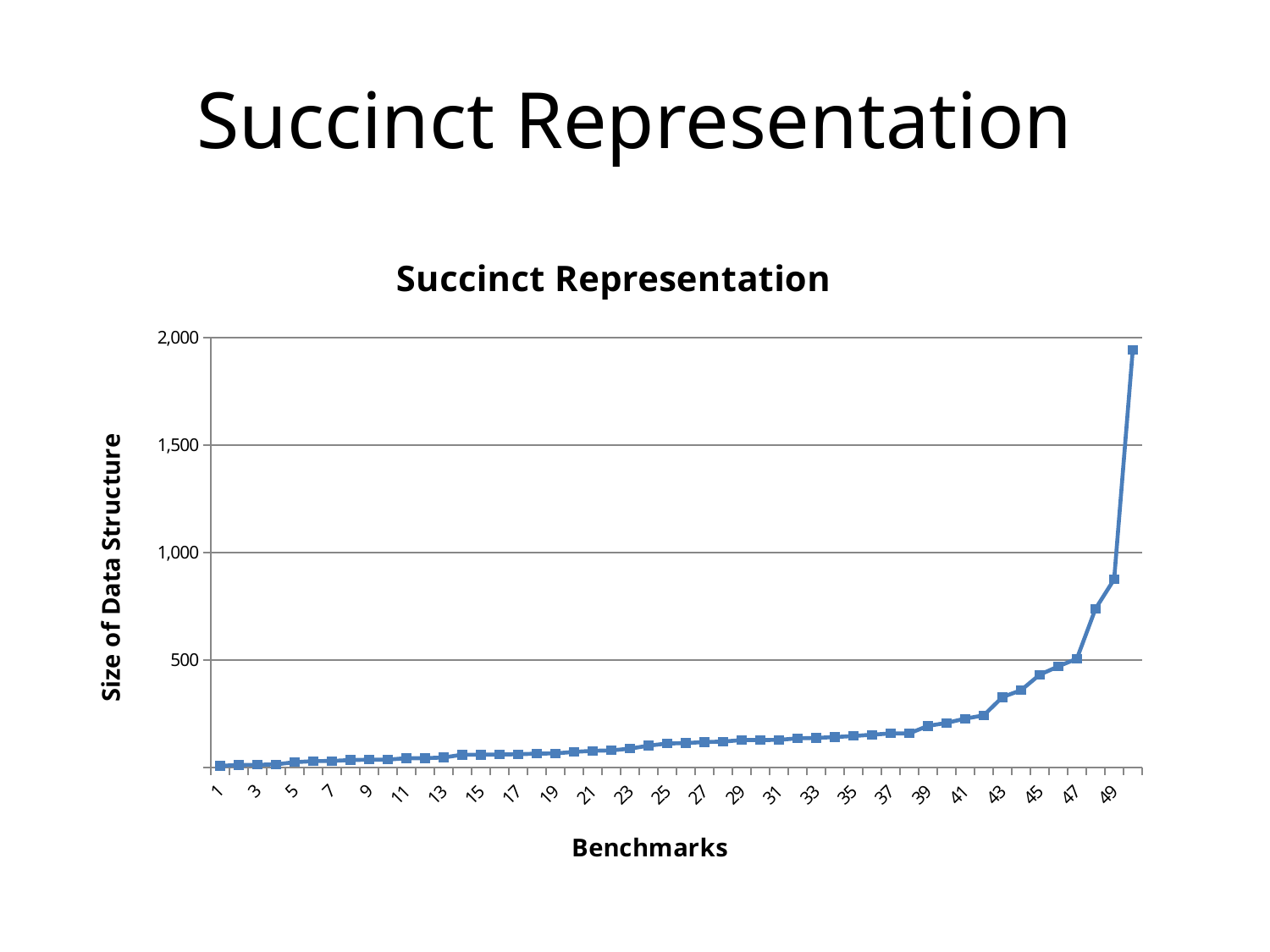
Which has a larger Size of Data Structure, benchmark 49 or benchmark 45? benchmark 49 What kind of chart is shown on the slide? line chart What is the label of the vertical axis? Size of Data Structure Which benchmark has the highest Size of Data Structure? the last benchmark (50) Which benchmark has the lowest Size of Data Structure? 1 What is the title of the chart? Succinct Representation Is the value for the last benchmark (50) greater or less than 1,500? greater Do the values rise or fall as you move from left to right along the Benchmarks axis? rise Is the value for benchmark 49 greater or less than 1,000? less Is the value for benchmark 45 greater or less than 500? less How many data points are plotted on the line? 50